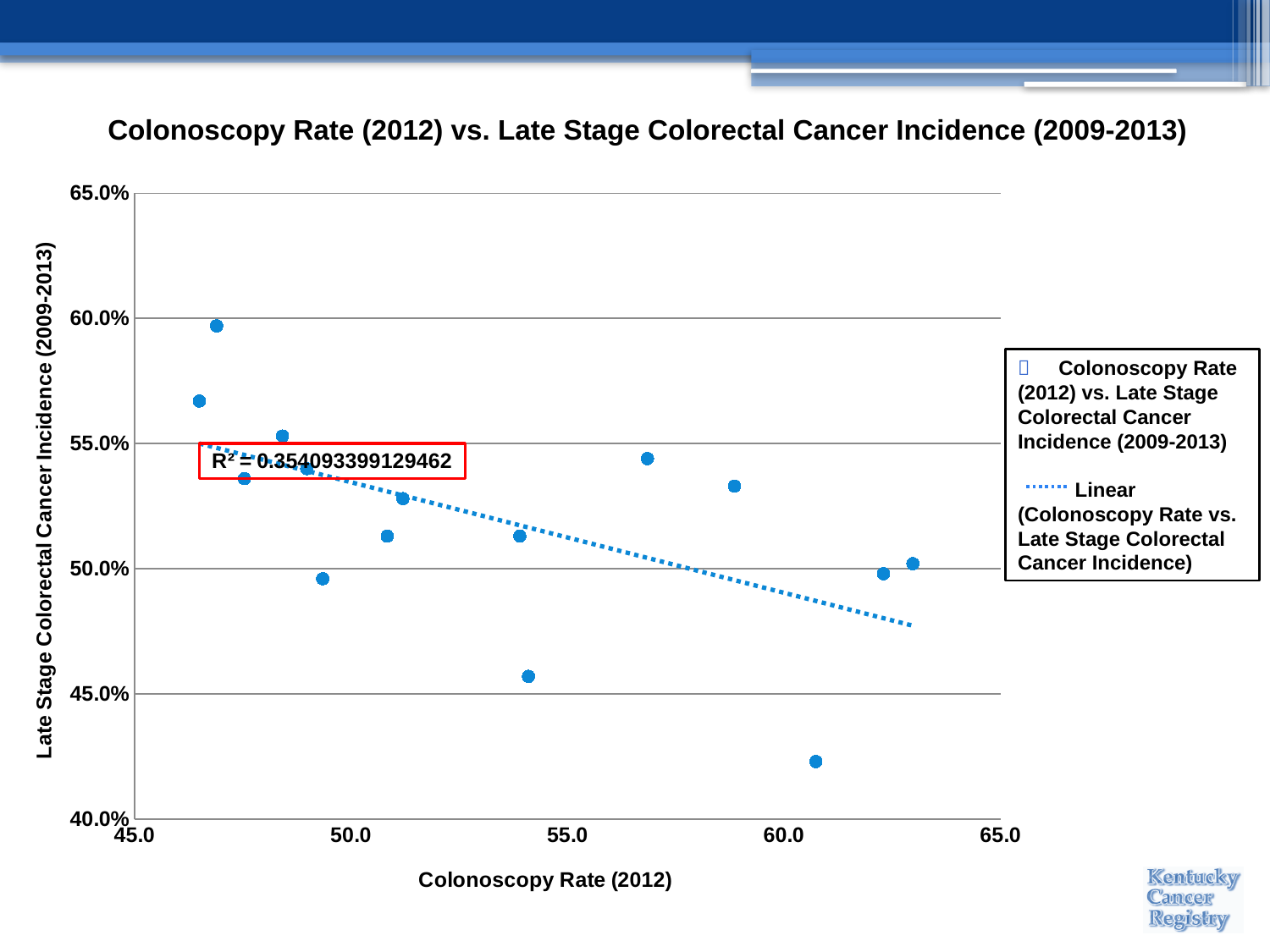
How many data points are plotted on the chart? 15 What R² value is printed on the chart? 0.354093399129462 What is the label of the x axis? Colonoscopy Rate (2012) Does the dotted linear trendline rise or fall as the colonoscopy rate increases along the x axis? Fall Is the lowest plotted point's late stage colorectal cancer incidence greater or less than 45.0%? less What kind of chart is shown on the slide? Scatter chart What is the minimum value shown on the x axis? 45.0 How many entries does the legend list? 2 What is the title of the chart? Colonoscopy Rate (2012) vs. Late Stage Colorectal Cancer Incidence (2009-2013) What is the maximum value shown on the y axis? 65.0% Is the colonoscopy rate of the lowest plotted point greater or less than 60.0? greater Is the highest plotted point's late stage colorectal cancer incidence greater or less than 55.0%? greater